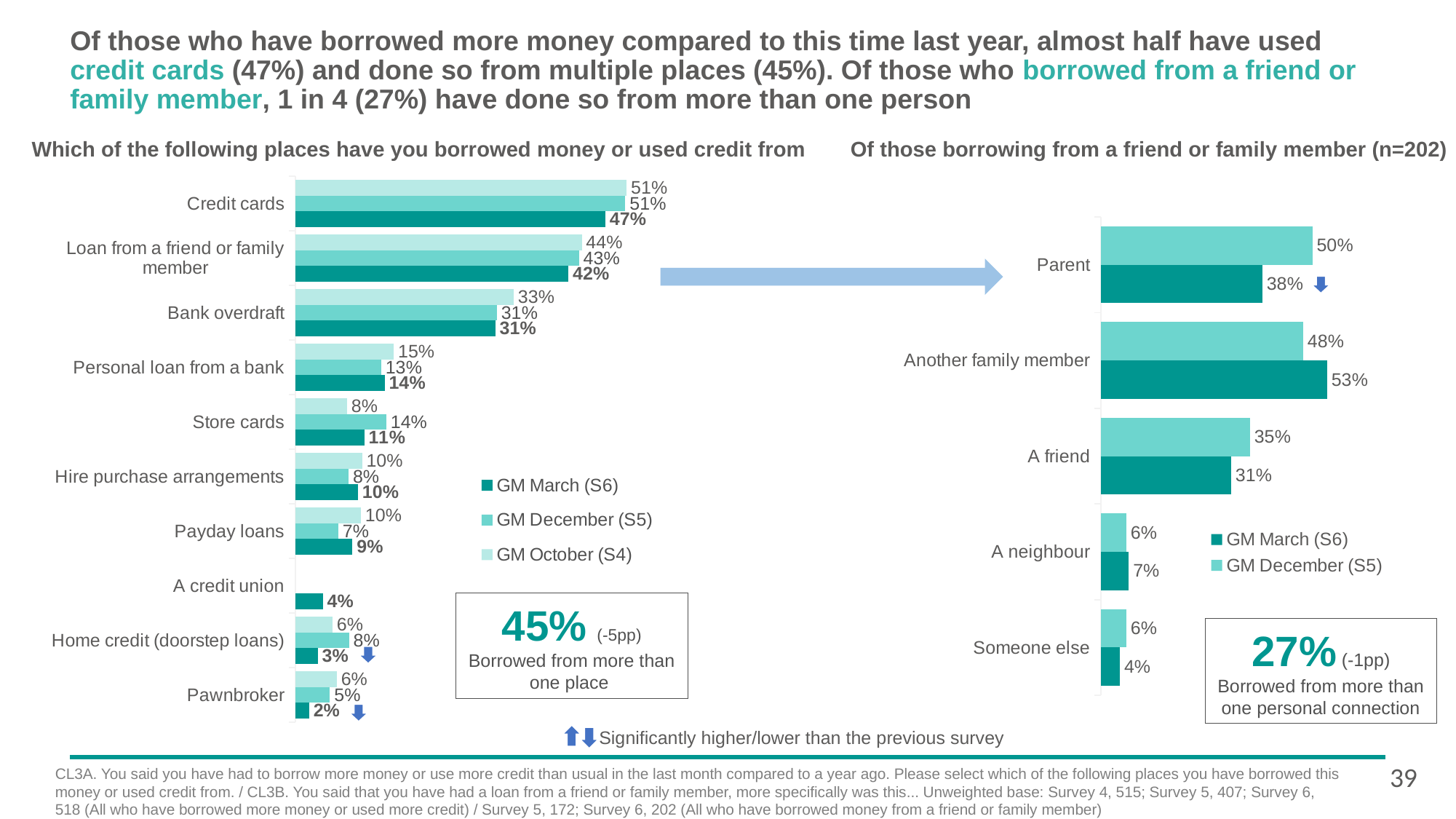
In the chart 'Of those borrowing from a friend or family member (n=202)', what is the difference between the GM December (S5) and GM March (S6) values for A friend? 4% What type of chart is 'Of those borrowing from a friend or family member (n=202)'? Bar chart In the chart 'Which of the following places have you borrowed money or used credit from', which category has the highest GM March (S6) value? Credit cards In the chart 'Which of the following places have you borrowed money or used credit from', what is the GM March (S6) value for Credit cards? 47% In the chart 'Which of the following places have you borrowed money or used credit from', what is the difference between the GM December (S5) and GM March (S6) values for Store cards? 3% In the chart 'Which of the following places have you borrowed money or used credit from', how many categories are shown? 10 In the chart 'Which of the following places have you borrowed money or used credit from', which category has the lowest GM March (S6) value? Pawnbroker In the chart 'Which of the following places have you borrowed money or used credit from', how many series does the legend list? 3 In the chart 'Of those borrowing from a friend or family member (n=202)', which category has the highest GM March (S6) value? Another family member In the chart 'Which of the following places have you borrowed money or used credit from', what is the GM October (S4) value for Bank overdraft? 33% In the chart 'Of those borrowing from a friend or family member (n=202)', what is the GM March (S6) value for Parent? 38% In the chart 'Of those borrowing from a friend or family member (n=202)', is the GM December (S5) value for Parent larger or smaller than the GM March (S6) value for Parent? larger